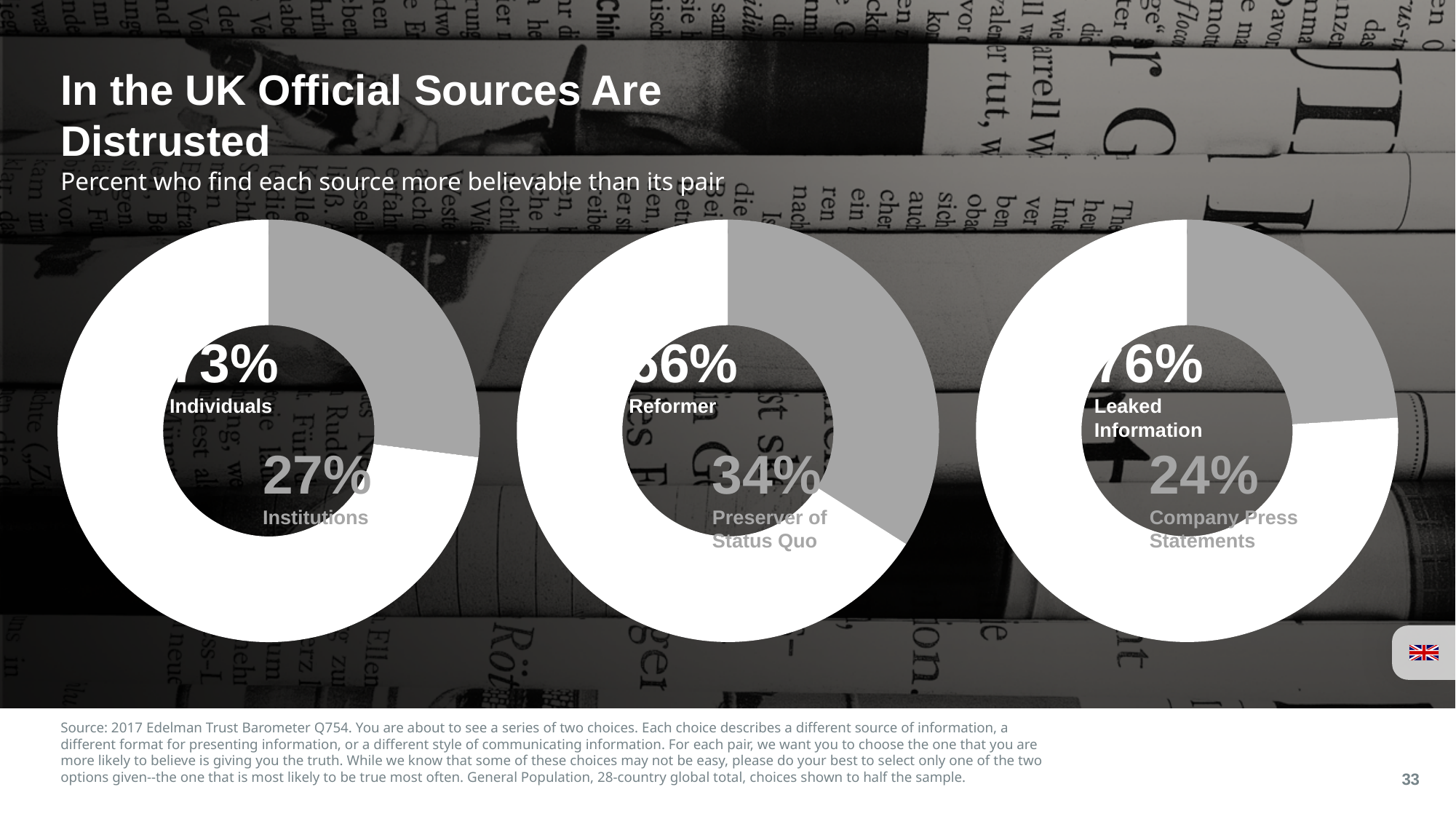
How many donut charts are on the slide? 3 What is the subtitle describing what the charts measure? Percent who find each source more believable than its pair What kind of chart is used on this slide? Donut (pie) chart In the right donut chart, which is larger, the slice for Leaked Information or the slice for Company Press Statements? Leaked Information Across the three donut charts, which grey-labelled source has the highest percentage? Preserver of Status Quo In the middle donut chart, which is larger, the slice for Reformer or the slice for Preserver of Status Quo? Reformer In the left donut chart, what percentage is shown for Institutions? 27% Across the three donut charts, which grey-labelled source has the lowest percentage? Company Press Statements In the left donut chart, which is larger, the slice for Individuals or the slice for Institutions? Individuals What is the difference between the percentage for Preserver of Status Quo and the percentage for Company Press Statements? 10% In the middle donut chart, what percentage is shown for Preserver of Status Quo? 34% In the right donut chart, what percentage is shown for Company Press Statements? 24%